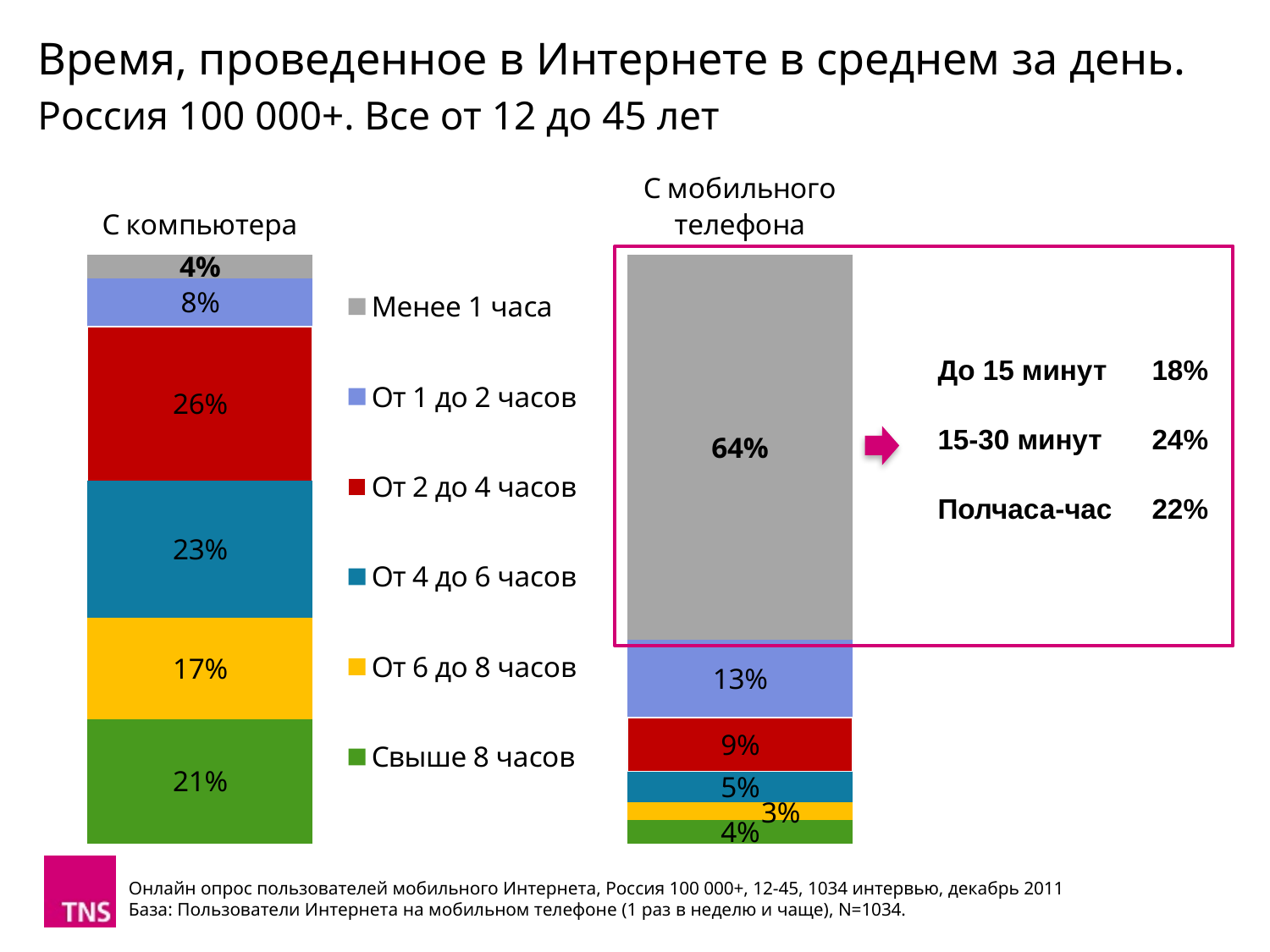
Which time category has the smallest share in the С мобильного телефона bar? От 6 до 8 часов What is the difference between the От 4 до 6 часов shares for С компьютера and С мобильного телефона? 18% How many time categories does the legend list? 6 Which is larger: the Менее 1 часа share for С компьютера or for С мобильного телефона? С мобильного телефона In the С компьютера bar, what is the value for Свыше 8 часов? 21% What share of mobile phone users (С мобильного телефона) spend less than 1 hour (Менее 1 часа) online per day? 64% In the С мобильного телефона bar, what is the value for От 1 до 2 часов? 13% What type of chart is used to show the time spent online? Stacked bar chart Which time category has the largest share in the С компьютера bar? От 2 до 4 часов What colour represents the От 6 до 8 часов category? Yellow What share of computer users (С компьютера) spend from 2 to 4 hours (От 2 до 4 часов) online per day? 26% Within the 64% of mobile users spending less than 1 hour, what share spend 15-30 минут? 24%